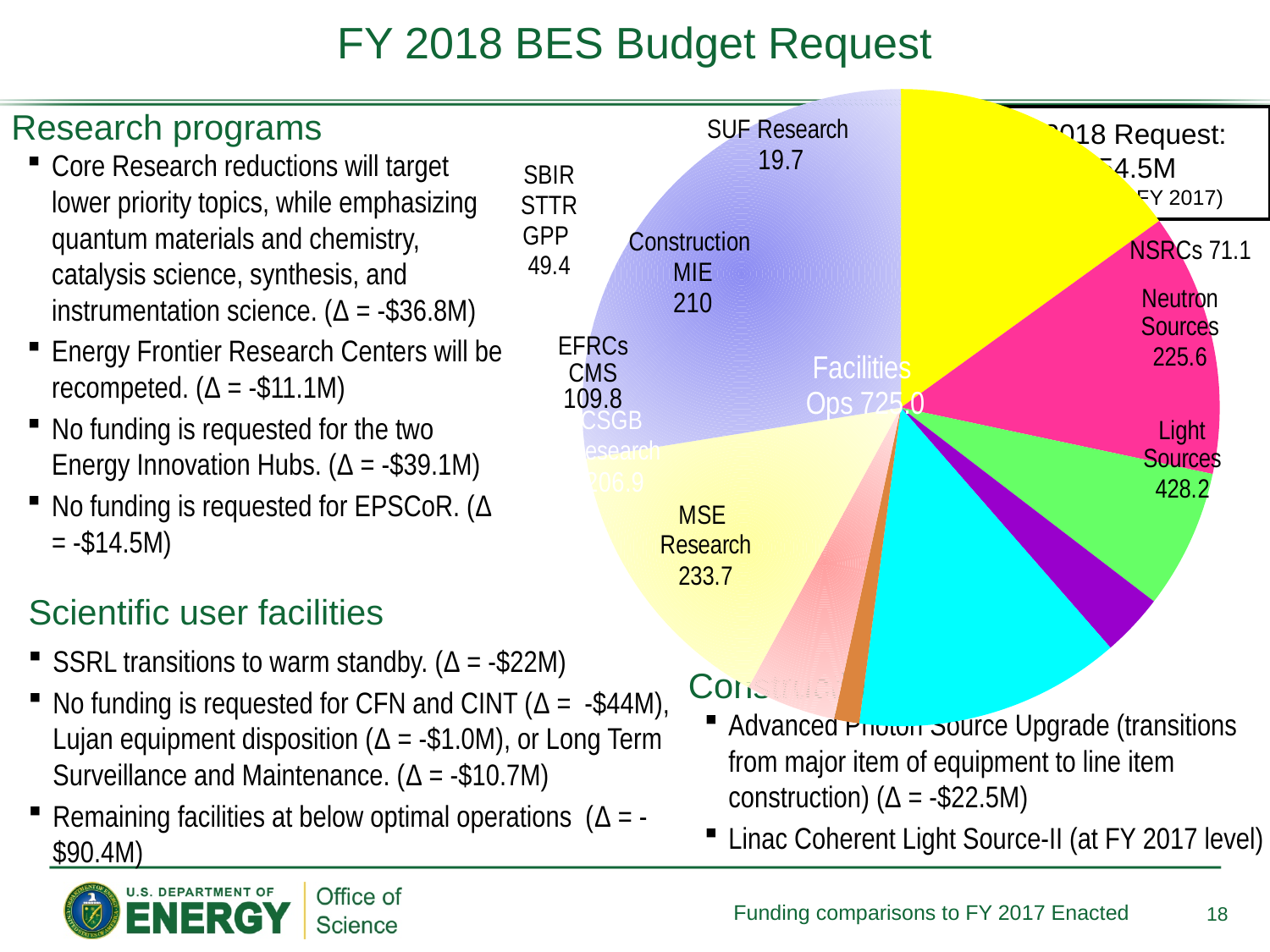
Which is larger in the pie chart, Light Sources or Neutron Sources? Light Sources What value is shown for EFRCs CMS in the pie chart? 109.8 What is the difference between the Light Sources value and the Neutron Sources value in the pie chart? 202.6 What value is shown for Construction MIE in the pie chart? 210 What value is shown for MSE Research in the pie chart? 233.7 What value is shown for Light Sources in the pie chart? 428.2 What value is shown for SUF Research in the pie chart? 19.7 What value is shown for Neutron Sources in the pie chart? 225.6 What value is printed for Facilities Ops in the pie chart? 725.0 What value is shown for NSRCs in the pie chart? 71.1 What kind of chart is shown on the slide? pie chart What is the difference between the MSE Research value and the EFRCs CMS value in the pie chart? 123.9